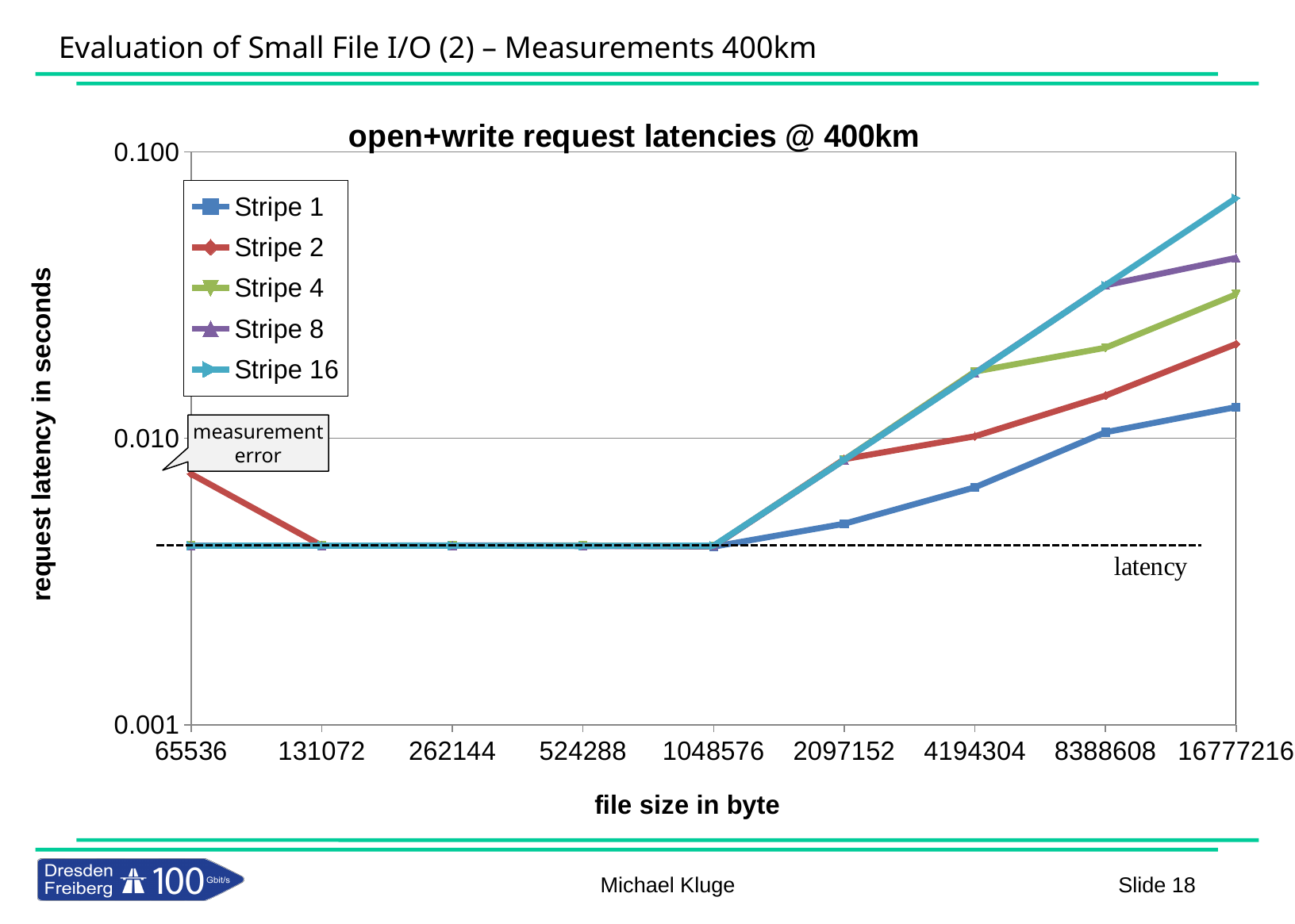
What is the title of the chart? open+write request latencies @ 400km Is the request latency for Stripe 2 at file size 65536 greater or less than 0.010? less How many series does the legend list? 5 At file size 16777216, which is larger: the latency for Stripe 8 or for Stripe 4? Stripe 8 Is the request latency for Stripe 1 at file size 2097152 greater or less than 0.010? less Does the request latency for Stripe 16 rise or fall from file size 1048576 to 16777216? rise What is the label of the y axis? request latency in seconds What kind of chart is shown on the slide? line chart Which series has the lowest request latency at file size 16777216? Stripe 1 Which series has the highest request latency at file size 16777216? Stripe 16 How many file size categories are shown on the x axis? 9 Is the request latency for Stripe 16 at file size 16777216 greater or less than 0.010? greater